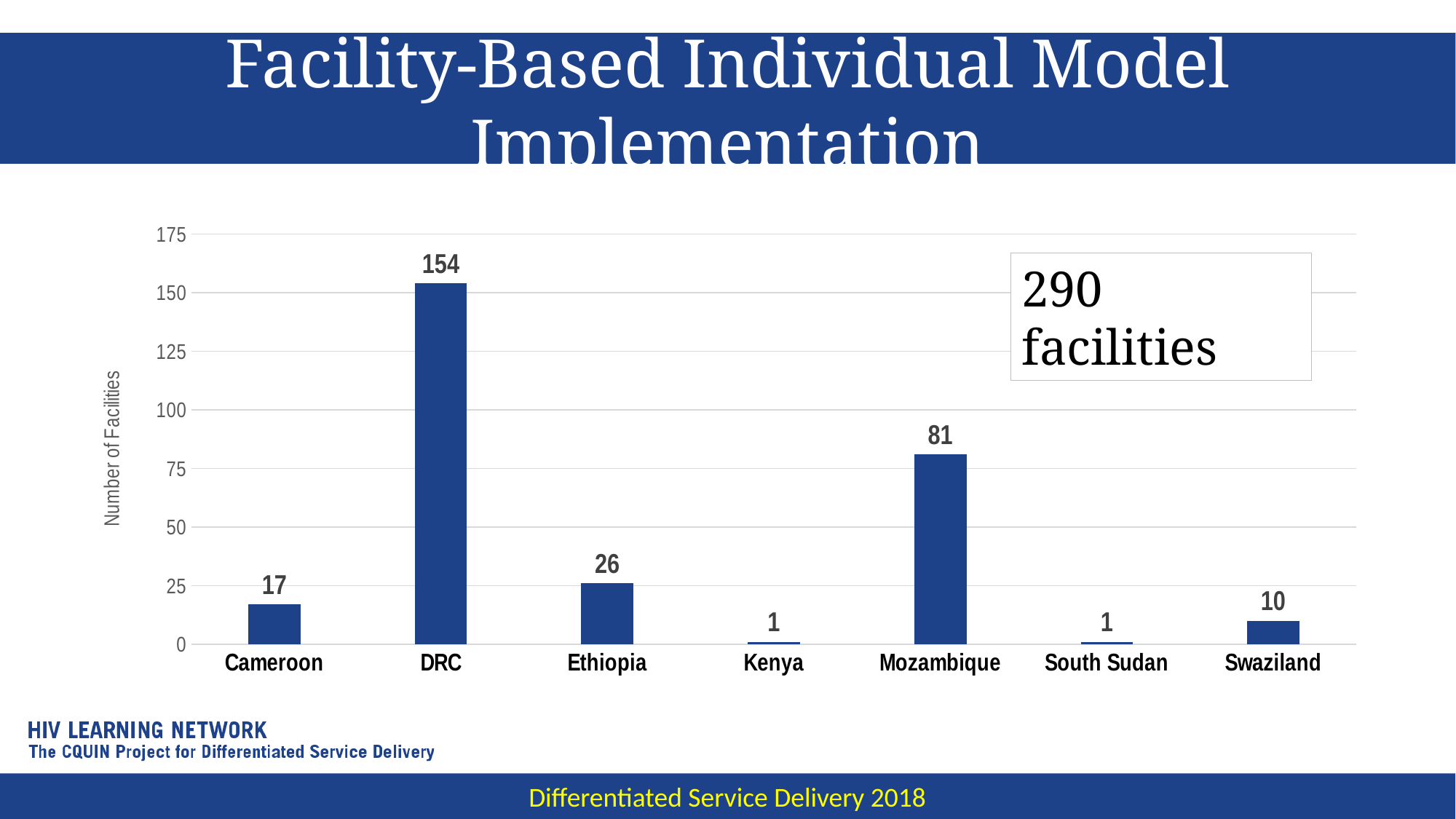
What is the number of facilities for Swaziland? 10 How many countries are shown on the x axis of the chart? 7 What is the number of facilities for Mozambique? 81 What is the difference in number of facilities between Ethiopia and Cameroon? 9 Is the value for Mozambique greater or less than 75? greater How many facilities does the chart show for DRC? 154 What kind of chart is shown on the slide? Bar chart What is the label of the vertical axis? Number of Facilities What is the difference in number of facilities between DRC and Mozambique? 73 Which country has the highest number of facilities? DRC Which has more facilities, Cameroon or Swaziland? Cameroon What total number of facilities is stated in the text box on the chart? 290 facilities